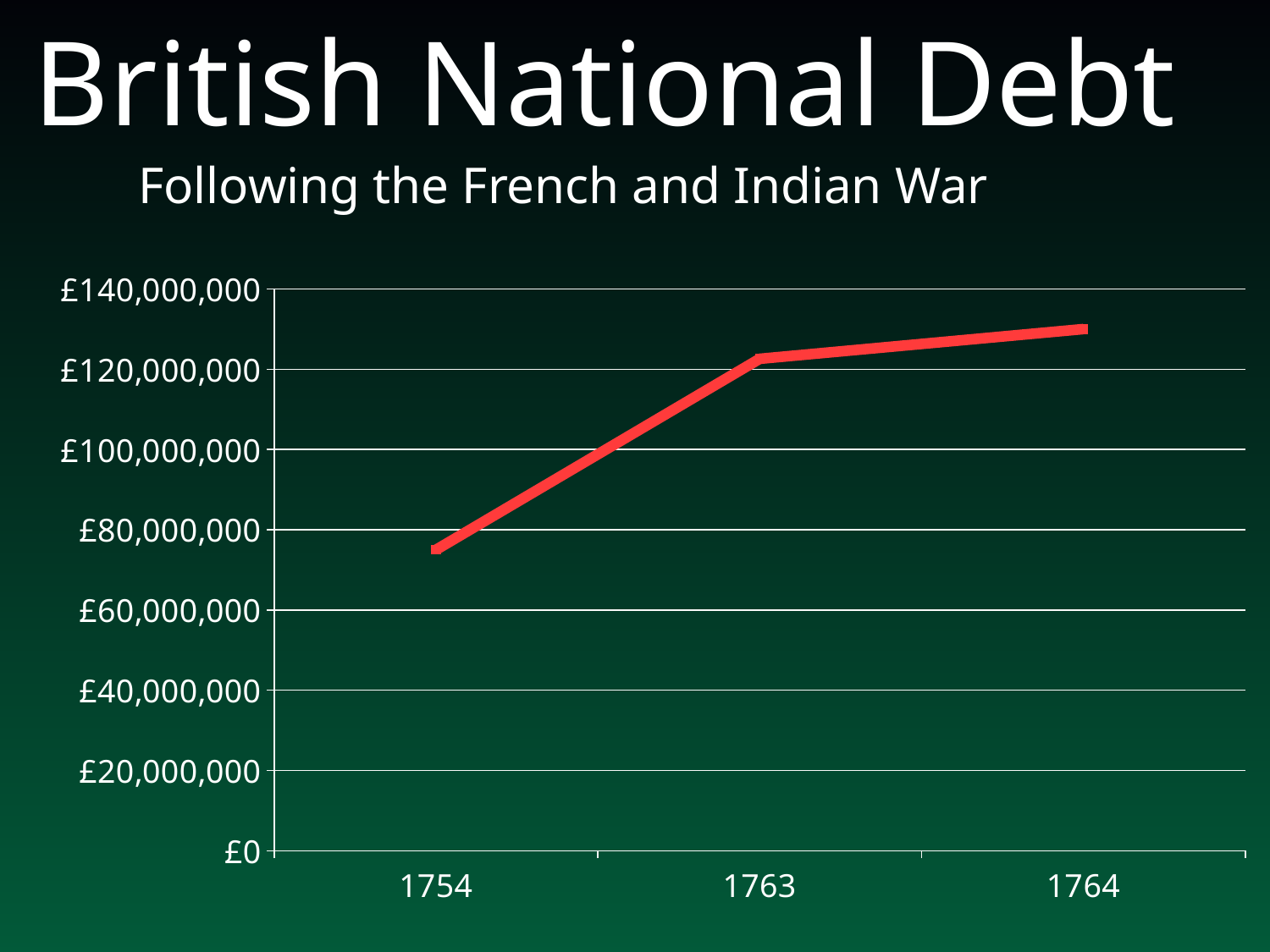
How many years are plotted on the x axis? 3 Is the value for 1764 greater or less than £140,000,000? less Does the national debt rise or fall from 1754 to 1764? rise Is the value for 1754 greater or less than £80,000,000? less What is the title of the chart? British National Debt Which is larger, the debt in 1754 or the debt in 1763? 1763 Is the value for 1754 greater or less than £60,000,000? greater What kind of chart is shown on the slide? line chart Which year has the highest national debt? 1764 Which year has the lowest national debt? 1754